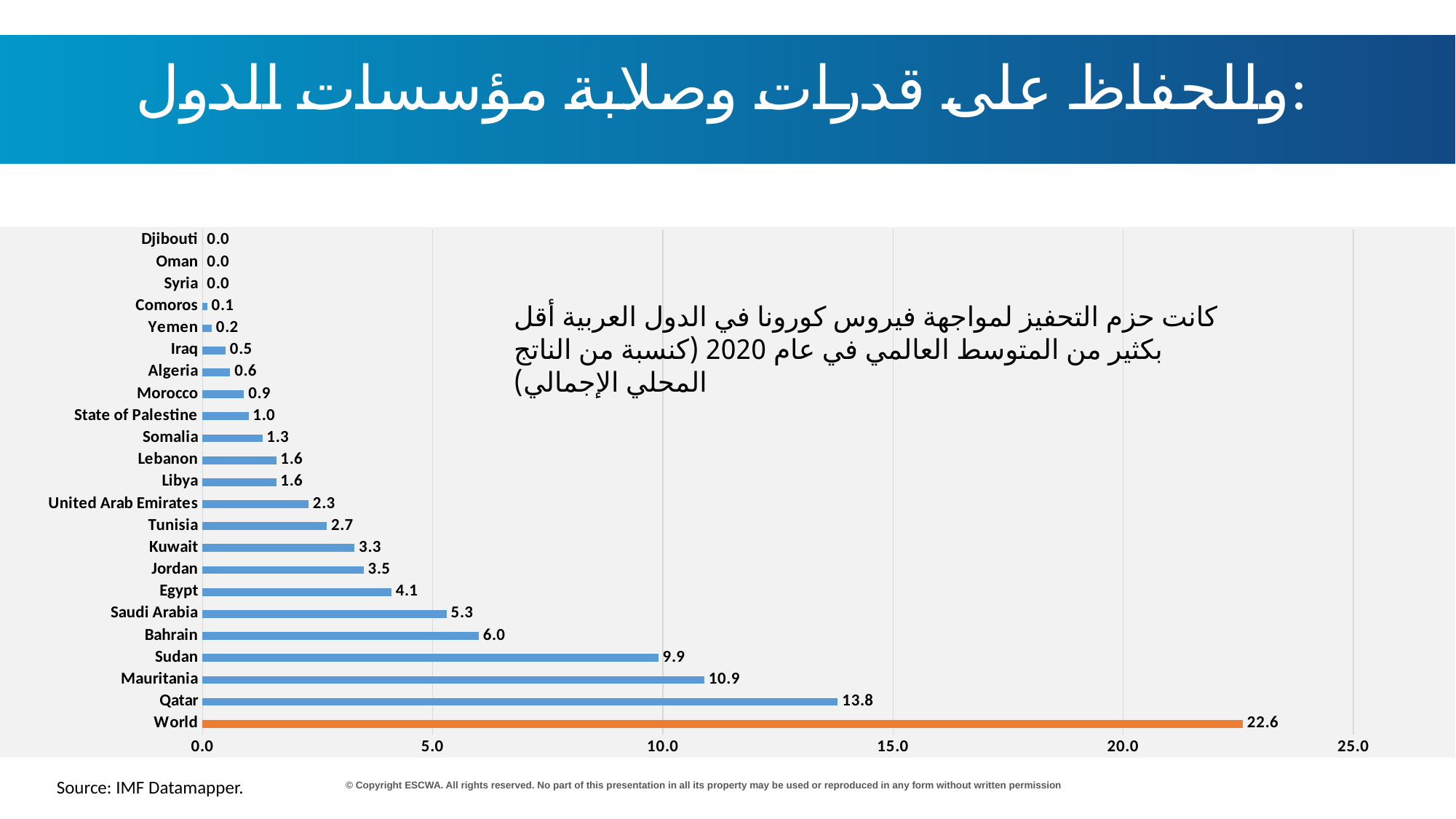
Is the value for Sudan greater or less than 10.0? less Which category has the highest value? World Which country has the highest value among the countries shown (excluding World)? Qatar What is the value for World? 22.6 What is the difference between the values for World and Qatar? 8.8 What is the difference between the values for Mauritania and Sudan? 1.0 How many categories are shown on the chart? 23 Which is larger, the value for Bahrain or the value for Egypt? Bahrain What is the value for Qatar? 13.8 What kind of chart is shown on the slide? Bar chart What is the value for State of Palestine? 1.0 What is the value for Saudi Arabia? 5.3